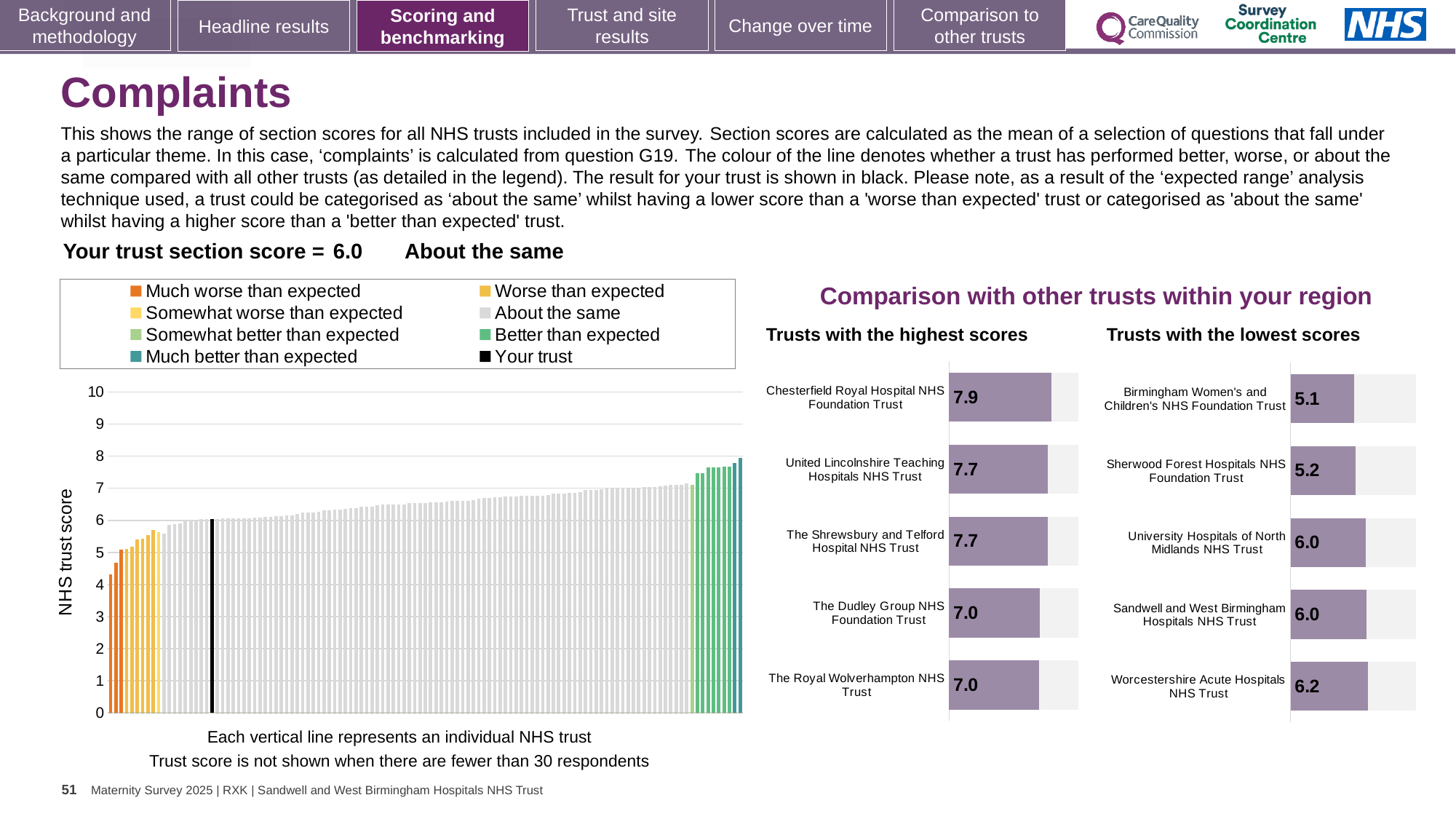
How many trusts are listed in the 'Trusts with the highest scores' chart? 5 In the 'Trusts with the lowest scores' chart, which has the larger score: Sherwood Forest Hospitals NHS Foundation Trust or Worcestershire Acute Hospitals NHS Trust? Worcestershire Acute Hospitals NHS Trust In the main NHS trust score chart, do the values rise or fall from left to right? rise In the 'Trusts with the lowest scores' chart, which trust has the lowest score? Birmingham Women's and Children's NHS Foundation Trust In the main chart on the left, is the value of the tallest bar greater or less than 7? greater In the 'Trusts with the highest scores' chart, what is the score for Chesterfield Royal Hospital NHS Foundation Trust? 7.9 What is your trust's section score for Complaints as shown on the slide? 6.0 In the 'Trusts with the highest scores' chart, which trust has the highest score? Chesterfield Royal Hospital NHS Foundation Trust In the 'Trusts with the lowest scores' chart, what is the score for Worcestershire Acute Hospitals NHS Trust? 6.2 How many entries does the legend of the main NHS trust score chart list? 8 In the 'Trusts with the highest scores' chart, what is the difference between the scores of Chesterfield Royal Hospital NHS Foundation Trust and The Dudley Group NHS Foundation Trust? 0.9 What kind of chart is the main chart on the left showing NHS trust scores? bar chart